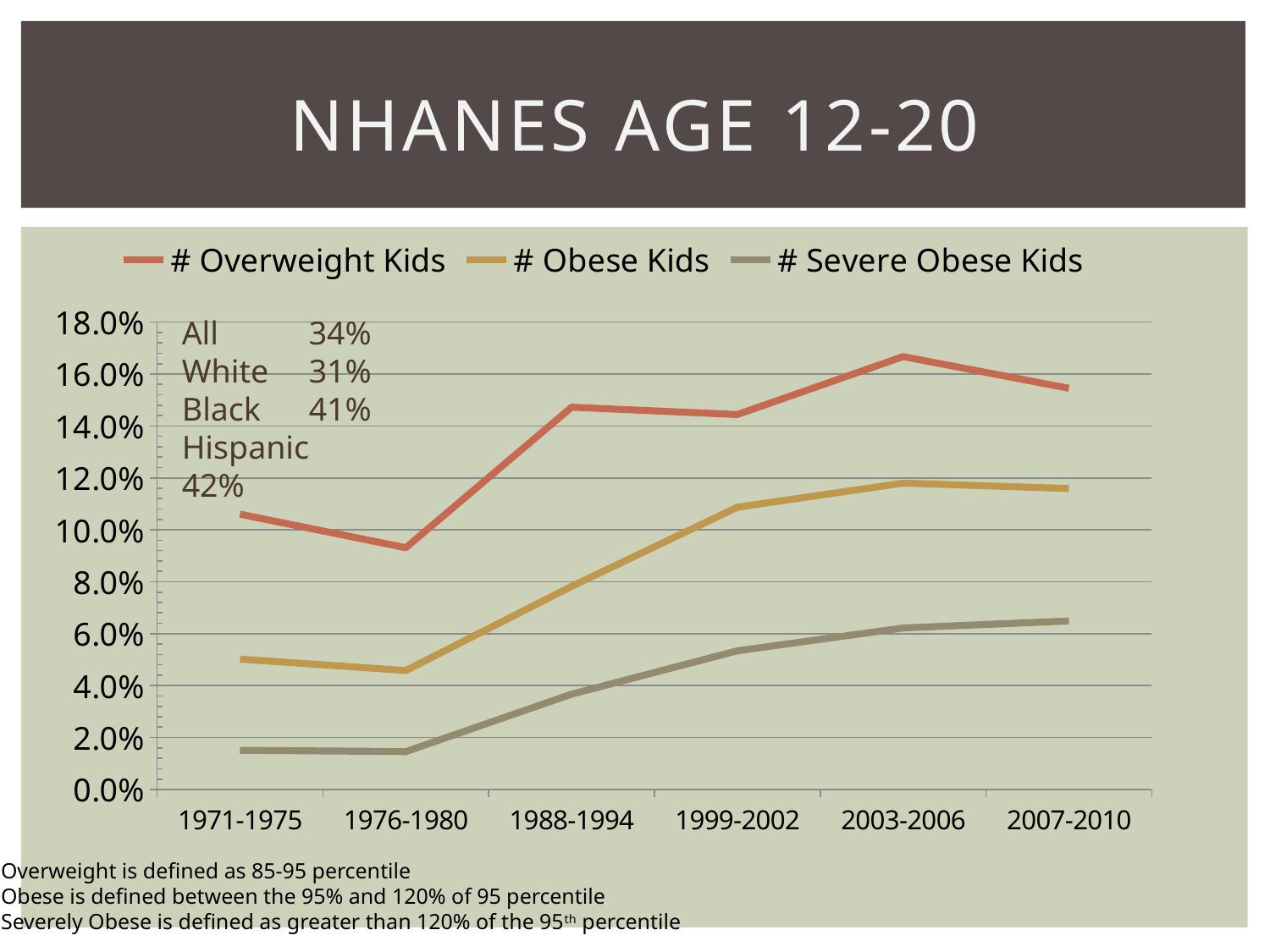
What is the title of the slide containing the chart? NHANES AGE 12-20 How many time periods are shown on the x axis? 6 How many series does the legend list? 3 Is the value for # Obese Kids in 2003-2006 greater or less than 10.0%? greater What type of chart is shown on the slide? Line chart In 2007-2010, which is larger: # Obese Kids or # Severe Obese Kids? # Obese Kids In which period is the value for # Overweight Kids lowest? 1976-1980 Is the value for # Overweight Kids in 1976-1980 greater or less than 10.0%? less Is the value for # Overweight Kids in 1988-1994 greater or less than 14.0%? greater In which period is the value for # Overweight Kids highest? 2003-2006 Does the # Severe Obese Kids line generally rise or fall from 1971-1975 to 2007-2010? Rise